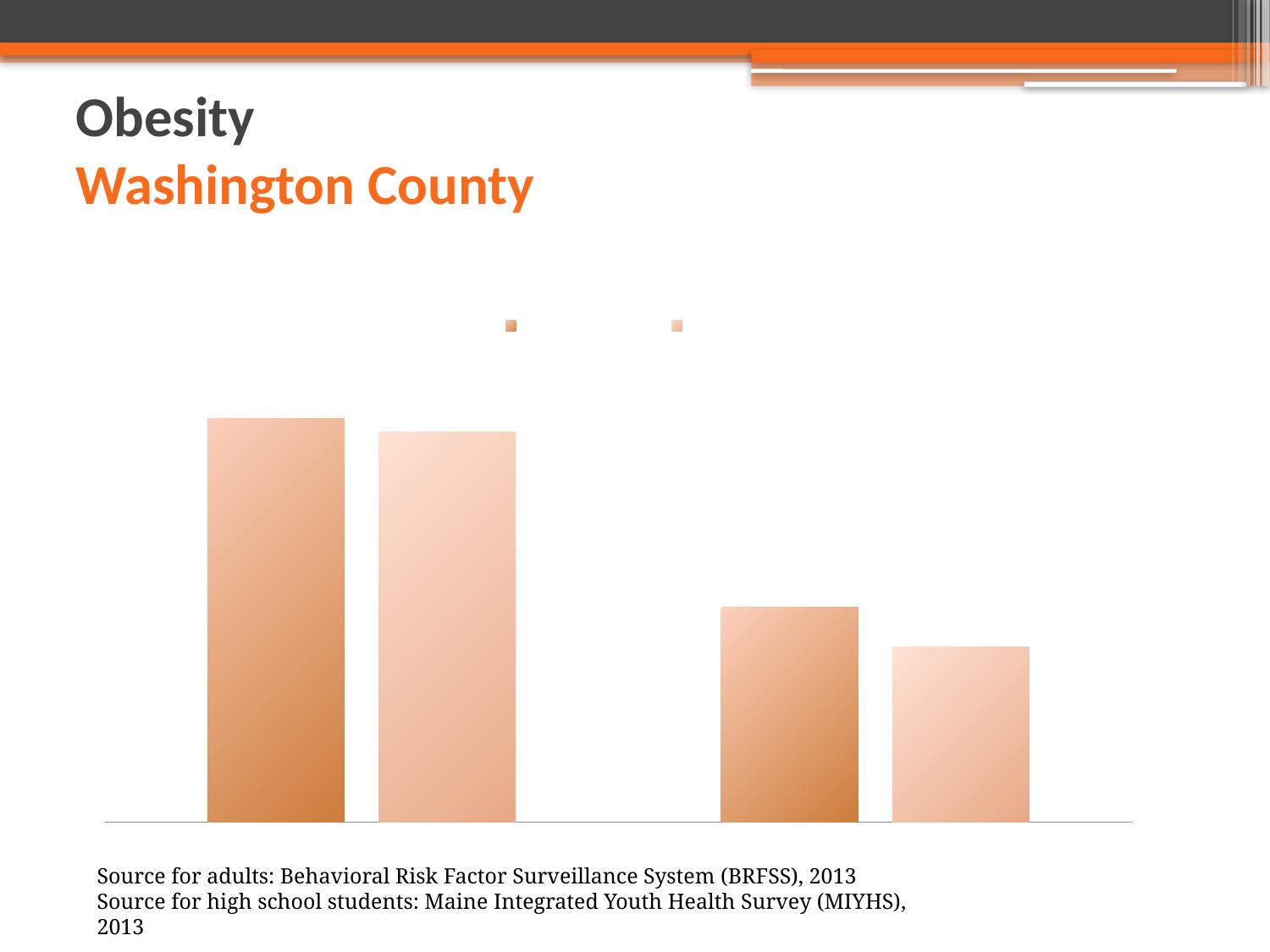
What kind of chart is shown on the slide? bar chart Which is taller, the leftmost bar or the rightmost bar? the leftmost bar How many series does the chart's legend list? 2 Which survey is cited as the source for adults? Behavioral Risk Factor Surveillance System (BRFSS), 2013 Which bar is the shortest in the chart? the rightmost bar How many bars are plotted in the chart? 4 What is the title text shown above the chart on the slide? Obesity Washington County Which bar is the tallest in the chart? the leftmost bar Are the two bars in the left group taller or shorter than the two bars in the right group? taller